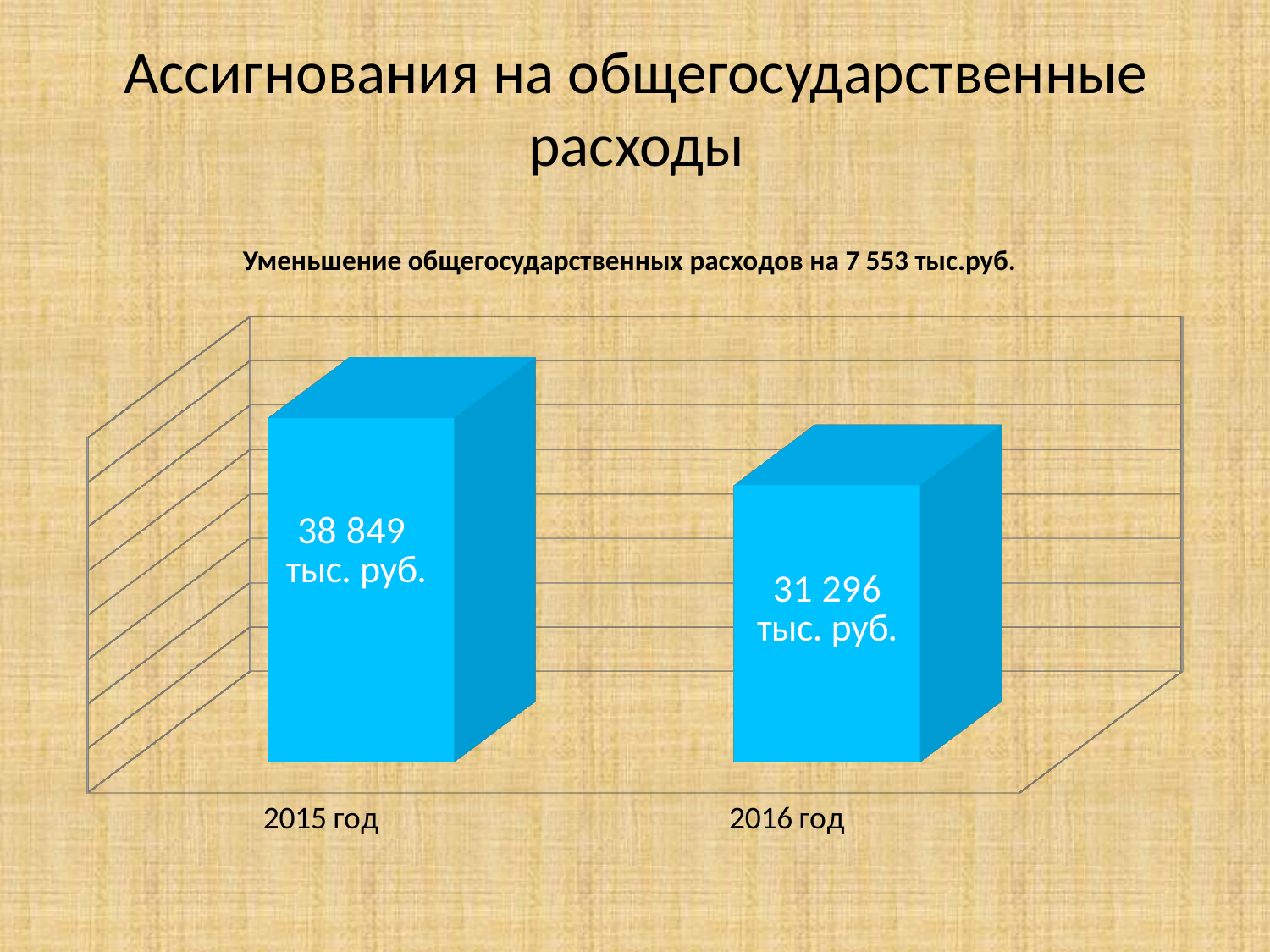
How many categories are shown on the chart? 2 What is the difference between the 2015 год and 2016 год values? 7 553 тыс. руб. What is the title of the slide? Ассигнования на общегосударственные расходы What is the value for 2016 год? 31 296 тыс. руб. What colour are the bars on the chart? blue Is the value for 2015 год larger or smaller than the value for 2016 год? larger What kind of chart is shown on the slide? bar chart Do the values rise or fall from 2015 год to 2016 год? fall Which year has the lower value? 2016 год Which year has the higher value? 2015 год What is the value for 2015 год? 38 849 тыс. руб.